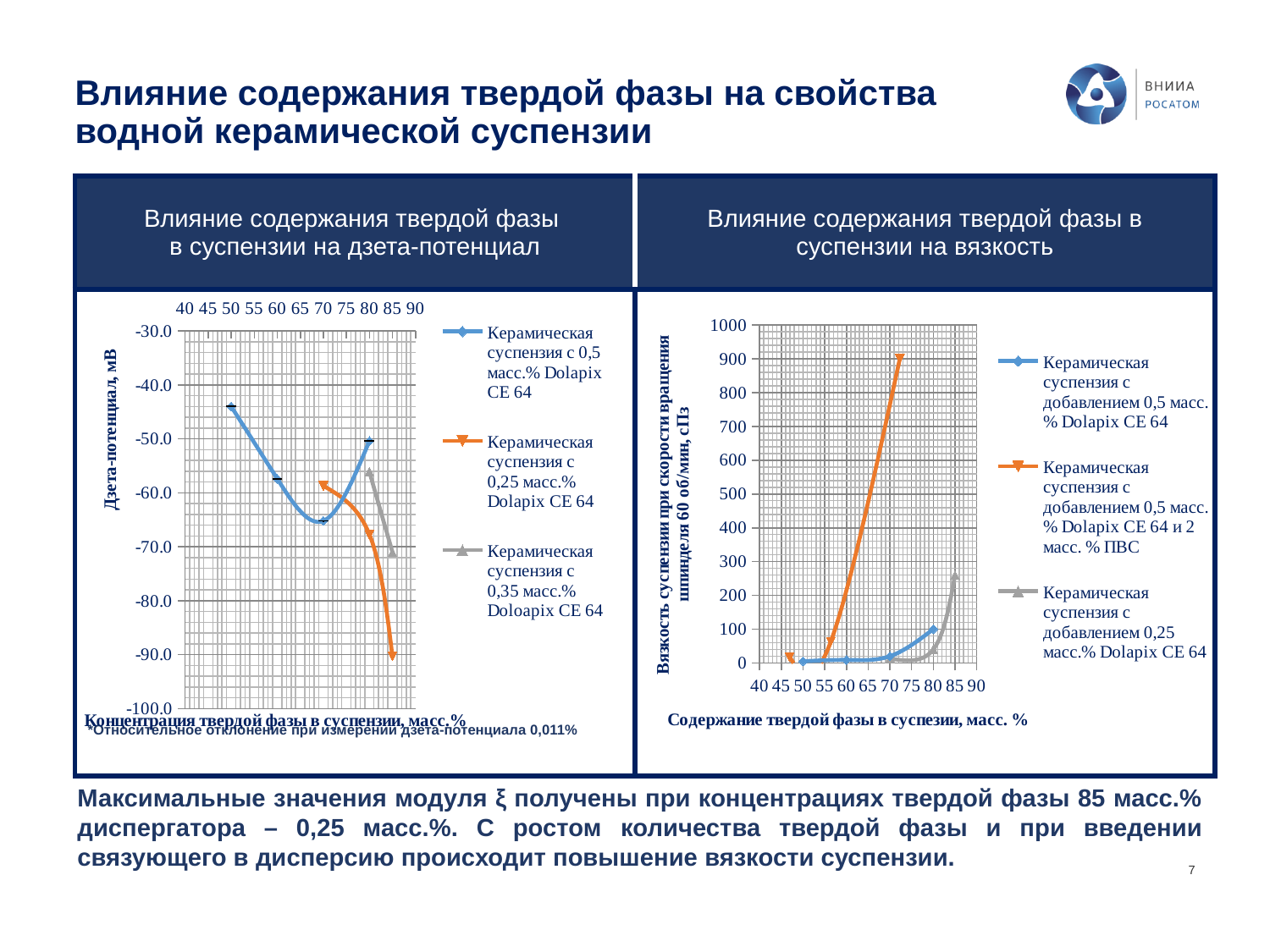
In the left chart (дзета-потенциал), which series reaches the lowest (most negative) zeta potential? Керамическая суспензия с 0,25 масс.% Dolapix CE 64 In the right chart (вязкость), which is larger: the viscosity of the series with 2 масс. % ПВС at 70 масс. % or the viscosity of the series with 0,25 масс.% Dolapix CE 64 at 85 масс. %? the series with 2 масс. % ПВС at 70 масс. % How many series does the legend of the left chart (дзета-потенциал) list? 3 What is the x-axis title of the right chart (вязкость)? Содержание твердой фазы в суспезии, масс. % In the right chart (вязкость), which series reaches the highest viscosity? Керамическая суспензия с добавлением 0,5 масс. % Dolapix CE 64 и 2 масс. % ПВС In the left chart (дзета-потенциал), is the value of the series 'Керамическая суспензия с 0,25 масс.% Dolapix CE 64' at 85 масс.% greater or less than -80.0? less In the right chart (вязкость), is the viscosity of the series 'Керамическая суспензия с добавлением 0,5 масс. % Dolapix CE 64' at 80 масс. % greater or less than 200? less How many series does the legend of the right chart (вязкость) list? 3 What kind of chart is the left chart, 'Влияние содержания твердой фазы в суспензии на дзета-потенциал'? line chart What is the x-axis title of the left chart (дзета-потенциал)? Концентрация твердой фазы в суспензии, масс.% In the right chart (вязкость), is the viscosity of the series 'Керамическая суспензия с добавлением 0,5 масс. % Dolapix CE 64 и 2 масс. % ПВС' at 70 масс. % greater or less than 500? greater In the right chart (вязкость), does the viscosity rise or fall as the solid phase content increases? rises